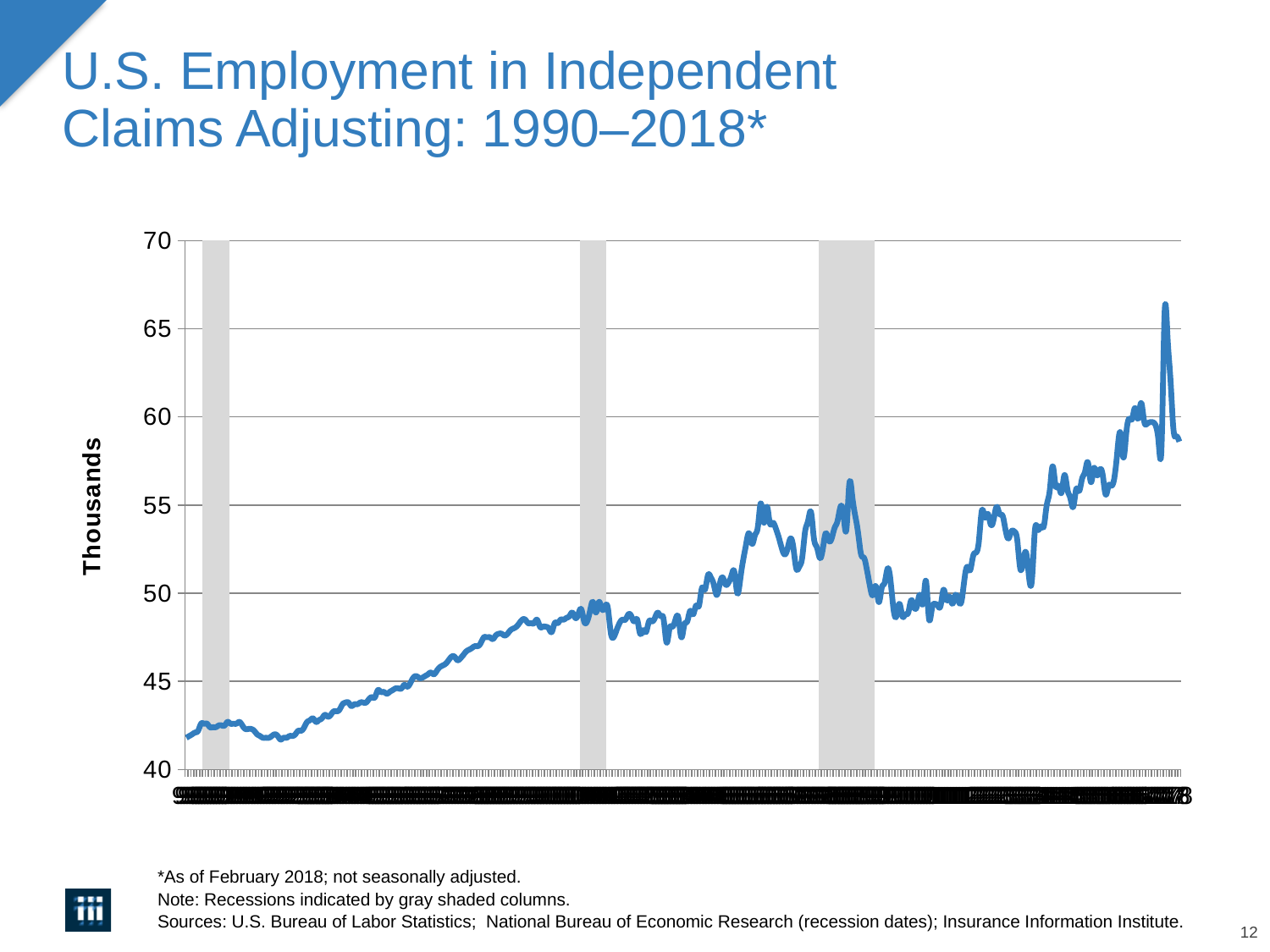
What is the label on the vertical axis of the chart? Thousands What is the highest value shown on the vertical axis? 70 What is the title of the chart on the slide? U.S. Employment in Independent Claims Adjusting: 1990–2018* Is the value at the start of the series (left end of the line) greater or less than 45? less Is the value at the right end of the line greater or less than 55? greater What kind of chart is shown on the slide? line chart Is the lowest point of the line greater or less than 40? greater Overall, do the values rise or fall from the left of the chart to the right? rise